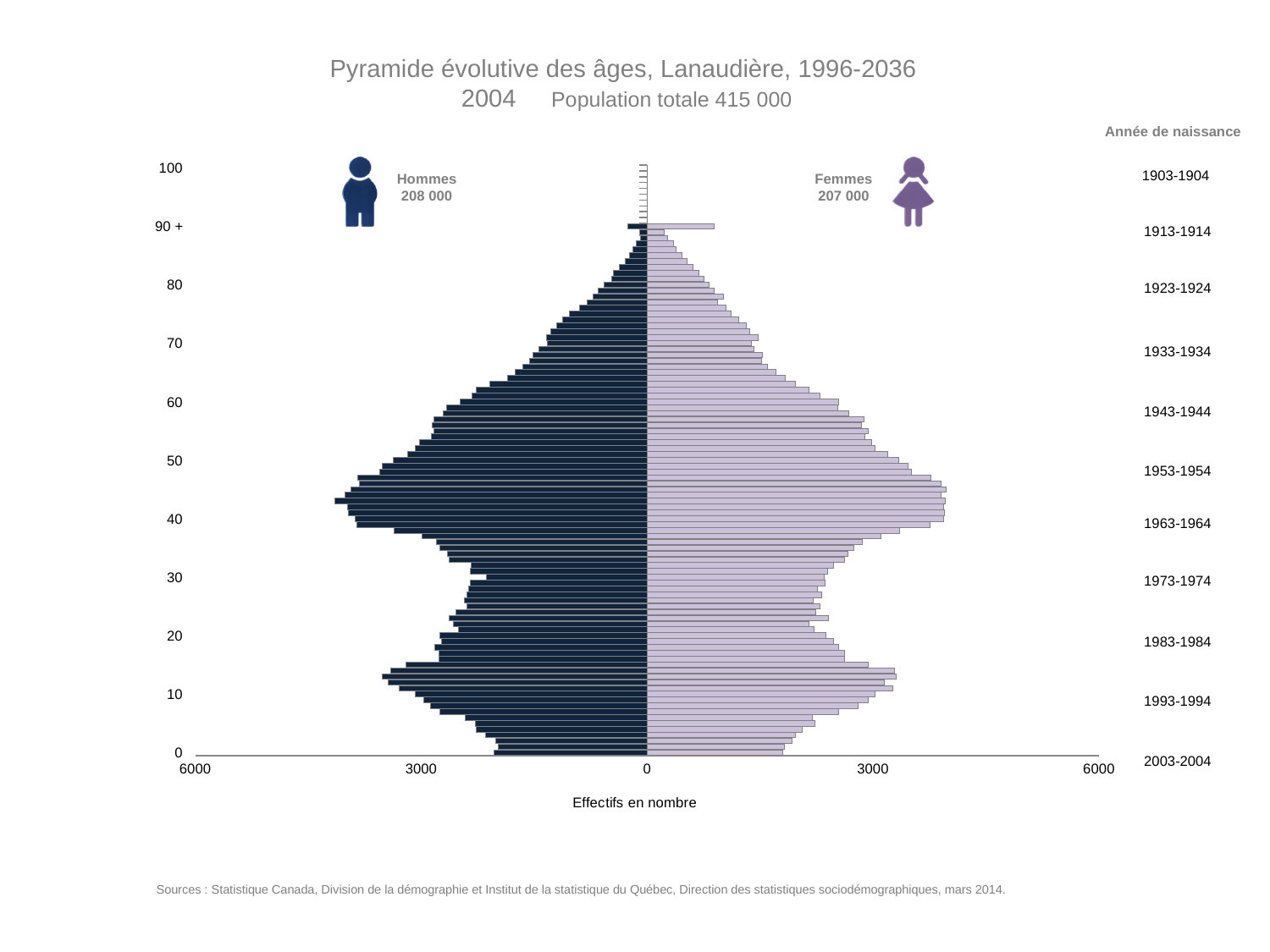
What is the number of Hommes shown on the chart? 208 000 How many series does the chart show? 2 What is the number of Femmes shown on the chart? 207 000 What kind of chart is shown on the slide? Bar chart (population pyramid) What year does the pyramid shown on the slide represent? 2004 Is the value for Hommes in the 90 + age group greater or less than 3000? less Is the value for Femmes in the 90 + age group greater or less than 3000? less Which group is larger, Hommes or Femmes? Hommes What is the label of the horizontal axis? Effectifs en nombre What is the difference between the number of Hommes and the number of Femmes? 1 000 What is the total population shown for 2004? 415 000 Is the value for Hommes at age 0 greater or less than 3000? less